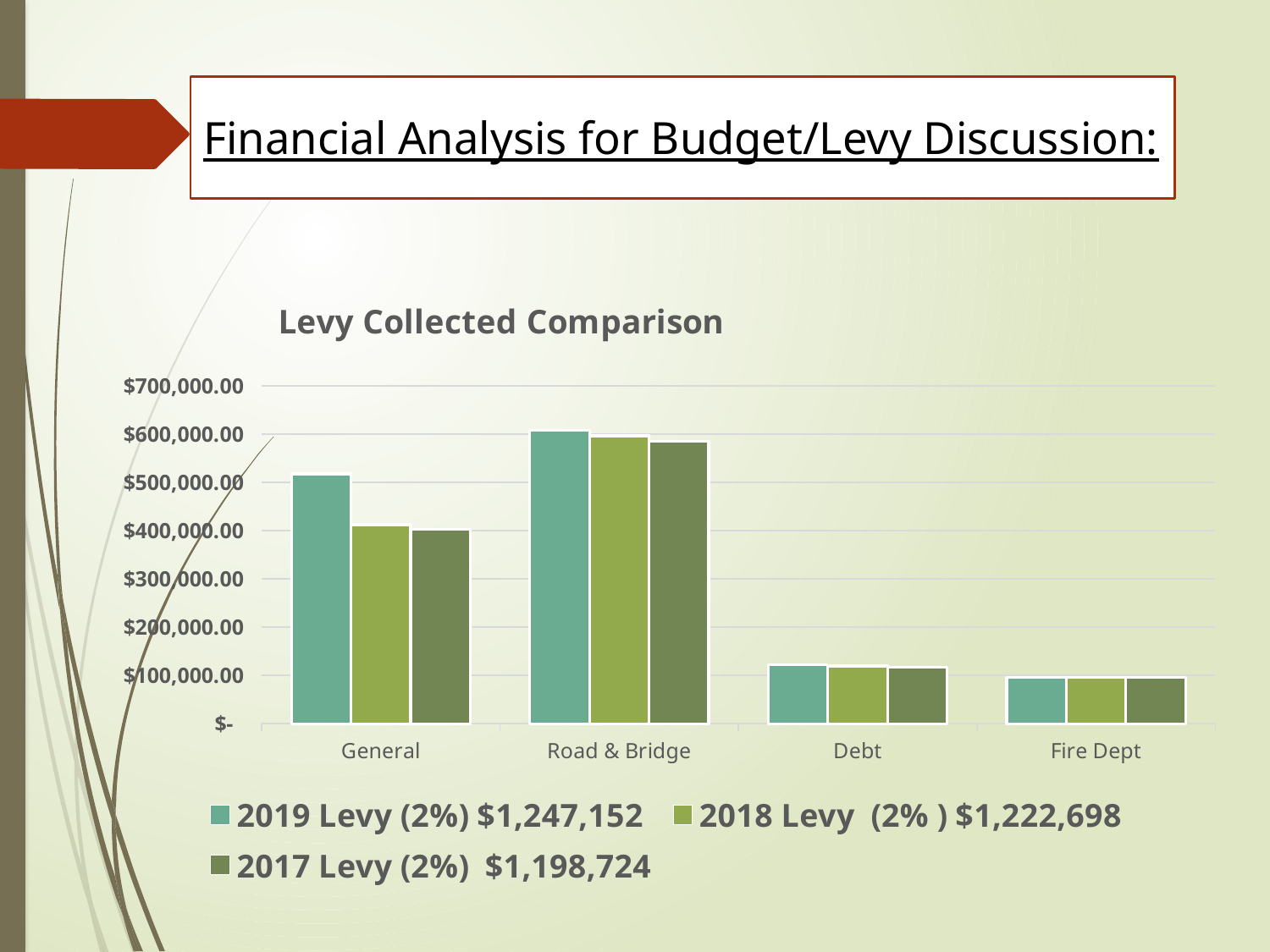
What is the title of the chart? Levy Collected Comparison What type of chart is shown on the slide? bar chart Is the 2018 Levy value for General greater or less than $300,000.00? greater Which category has the lowest value for the 2017 Levy series? Fire Dept Is the 2019 Levy value for Debt greater or less than $100,000.00? greater For the General category, which is larger: the 2019 Levy value or the 2018 Levy value? 2019 Levy Is the 2017 Levy value for Road & Bridge greater or less than $500,000.00? greater What total amount is shown in the legend entry for the 2019 Levy (2%) series? $1,247,152 Which category has the highest value for the 2019 Levy series? Road & Bridge How many categories are shown on the x axis of the chart? 4 How many series does the chart's legend list? 3